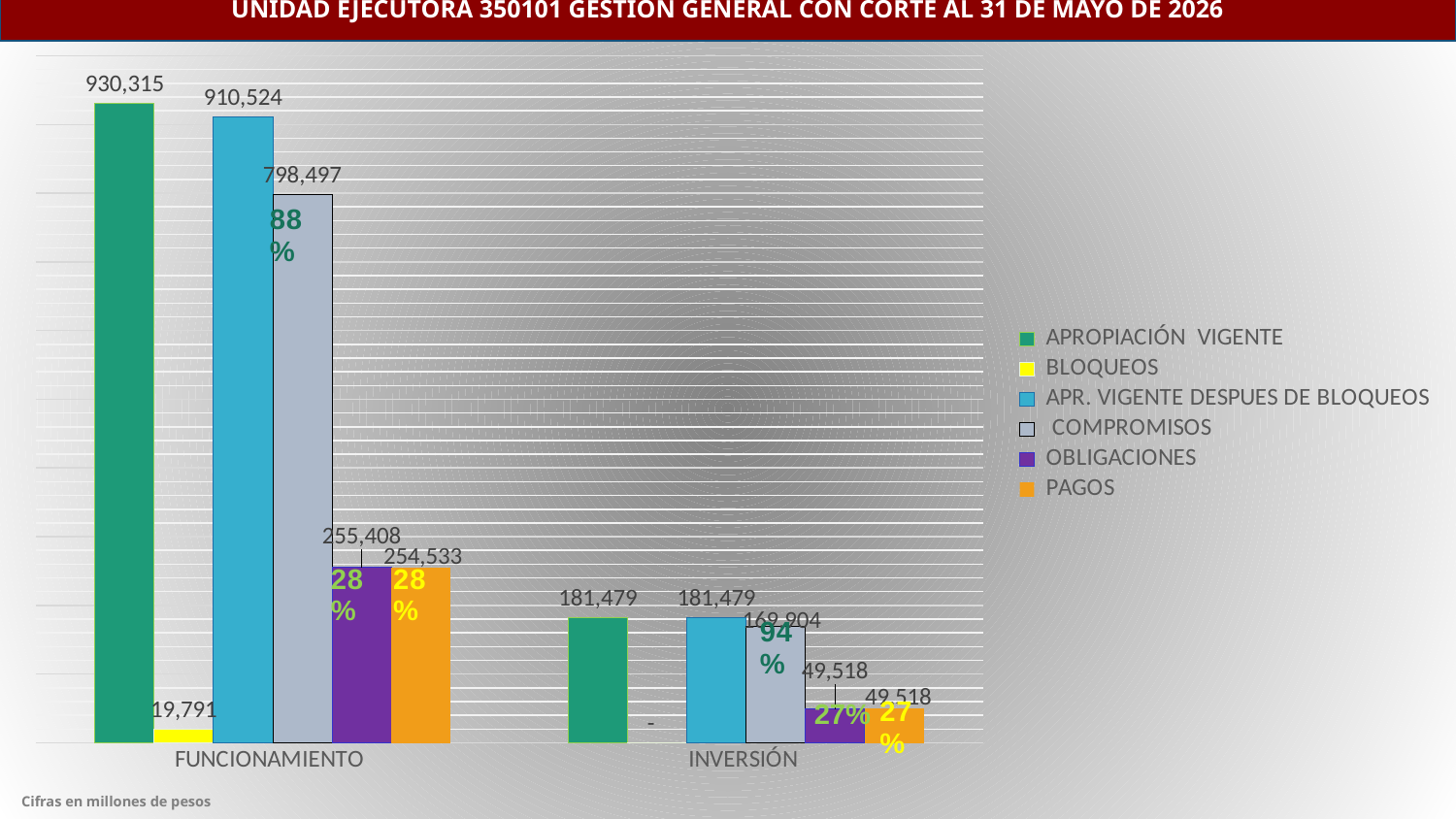
What is the APROPIACIÓN VIGENTE value for FUNCIONAMIENTO? 930,315 Which is larger: COMPROMISOS for FUNCIONAMIENTO or COMPROMISOS for INVERSIÓN? COMPROMISOS for FUNCIONAMIENTO How many series does the legend list? 6 Which series has the lowest value for FUNCIONAMIENTO? BLOQUEOS What is the BLOQUEOS value for FUNCIONAMIENTO? 19,791 What is the difference between APROPIACIÓN VIGENTE and APR. VIGENTE DESPUES DE BLOQUEOS for FUNCIONAMIENTO? 19,791 What is the COMPROMISOS value for INVERSIÓN? 169,904 What kind of chart is shown on the slide? Bar chart What is the PAGOS value for INVERSIÓN? 49,518 What is the APR. VIGENTE DESPUES DE BLOQUEOS value for FUNCIONAMIENTO? 910,524 How many categories are shown on the x axis? 2 Which series has the highest value for FUNCIONAMIENTO? APROPIACIÓN VIGENTE